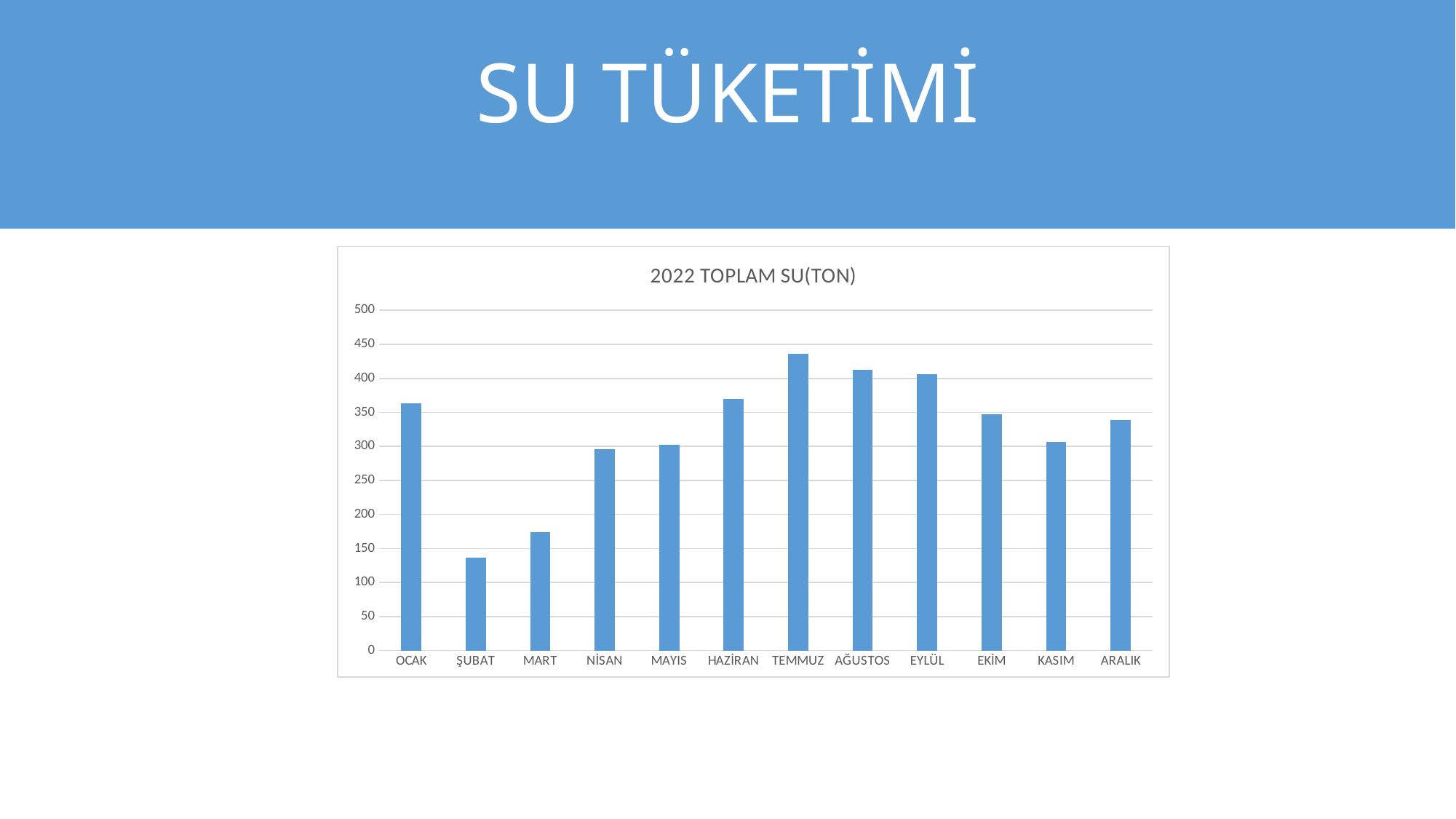
What is the title of the chart? 2022 TOPLAM SU(TON) Which is larger, the value for MART or the value for ARALIK? ARALIK Is the value for ŞUBAT greater or less than 150? less What type of chart is shown on the slide? Bar chart Which month has the highest value in the chart? TEMMUZ Is the value for MART greater or less than 200? less Which is larger, the value for HAZİRAN or the value for NİSAN? HAZİRAN Is the value for TEMMUZ greater or less than 400? greater Do the values rise or fall from ŞUBAT to TEMMUZ? rise Which month has the lowest value in the chart? ŞUBAT How many months (categories) are shown on the x axis of the chart? 12